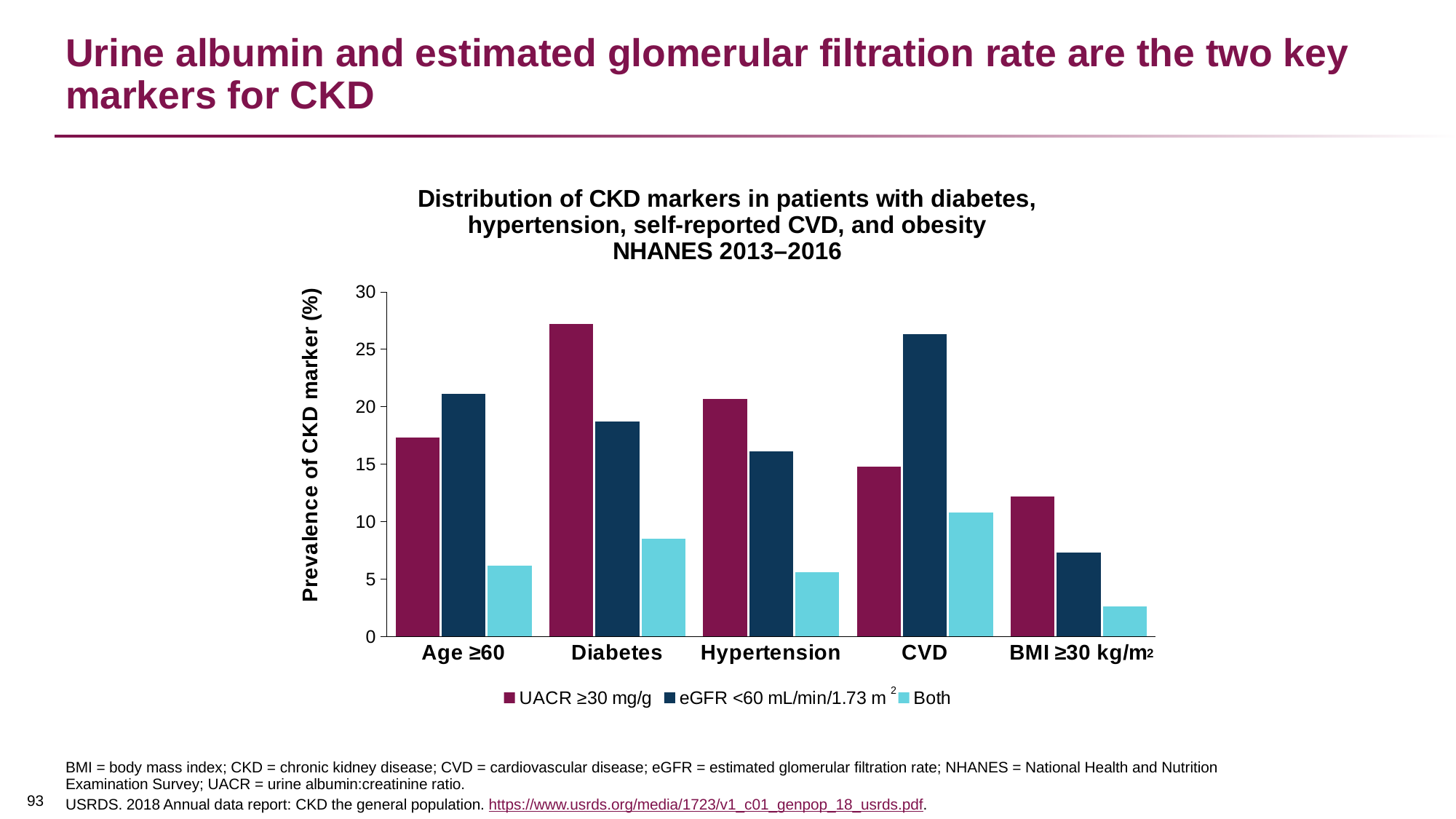
What kind of chart is shown on the slide? Bar chart For Age ≥60, which is larger: the UACR ≥30 mg/g value or the eGFR <60 mL/min/1.73 m2 value? eGFR <60 mL/min/1.73 m2 What is the label of the chart's y axis? Prevalence of CKD marker (%) Which category has the highest value for the UACR ≥30 mg/g series? Diabetes Is the eGFR <60 mL/min/1.73 m2 value for Hypertension greater or less than 20? less Is the eGFR <60 mL/min/1.73 m2 value for BMI ≥30 kg/m2 greater or less than 10? less Which category has the highest value for the eGFR <60 mL/min/1.73 m2 series? CVD Is the UACR ≥30 mg/g value for Diabetes greater or less than 25? greater How many patient categories are shown on the x axis of the chart? 5 Which category has the lowest value for the Both series? BMI ≥30 kg/m2 Which category has the highest value for the Both series? CVD How many series does the chart's legend list? 3